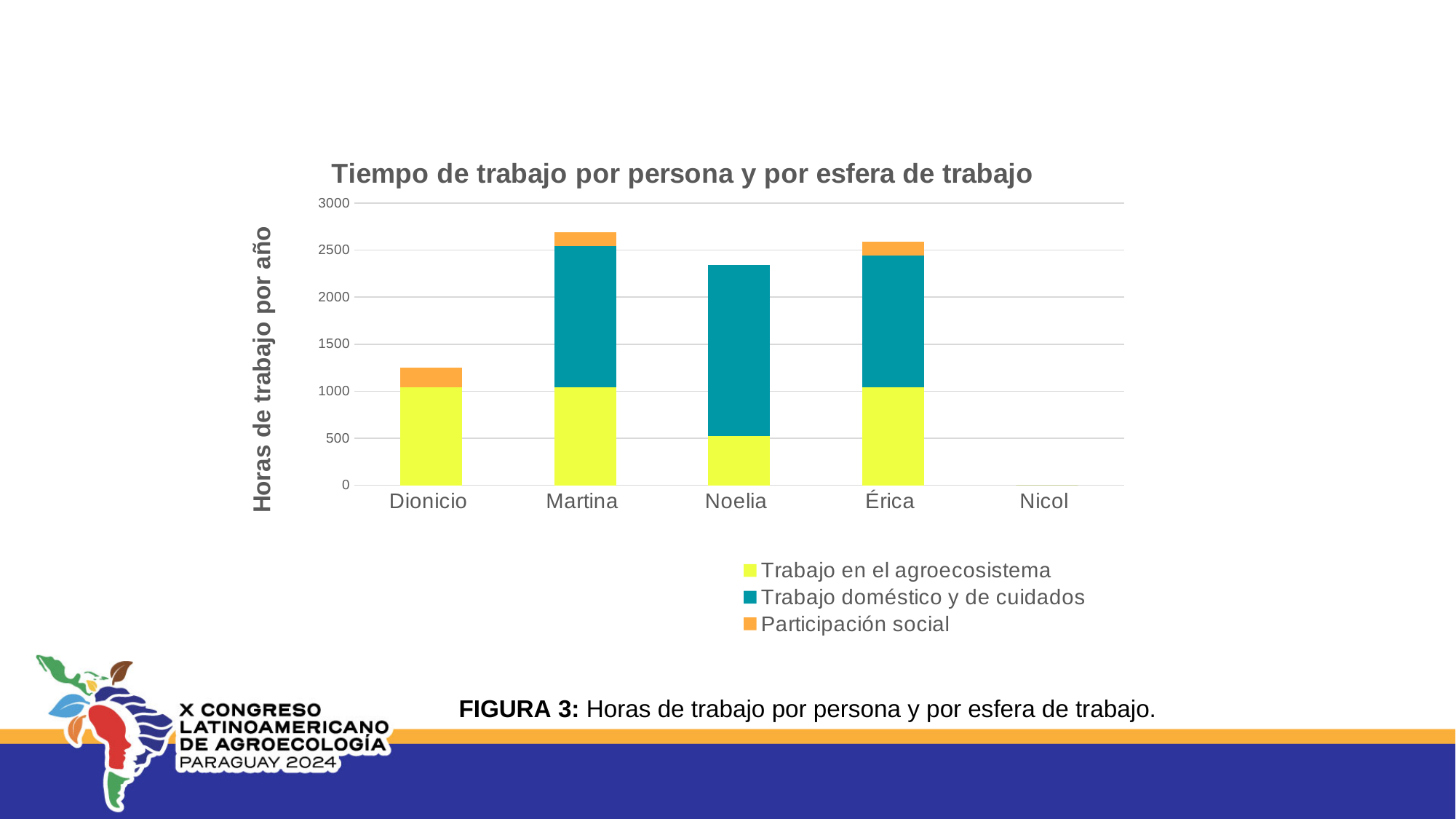
Is the total value for Dionicio greater or less than 1500? less Who has the larger total hours of work per year, Noelia or Dionicio? Noelia Is the 'Trabajo en el agroecosistema' value for Noelia greater or less than 1000? less Which person has the highest total hours of work per year? Martina Which person has the lowest total hours of work per year? Nicol How many series does the chart legend list? 3 Is the total value for Noelia greater or less than 2000? greater What is the title of the chart? Tiempo de trabajo por persona y por esfera de trabajo What is the label of the vertical axis? Horas de trabajo por año How many people (categories) are shown on the x axis of the chart? 5 What kind of chart is shown on the slide? Stacked bar chart